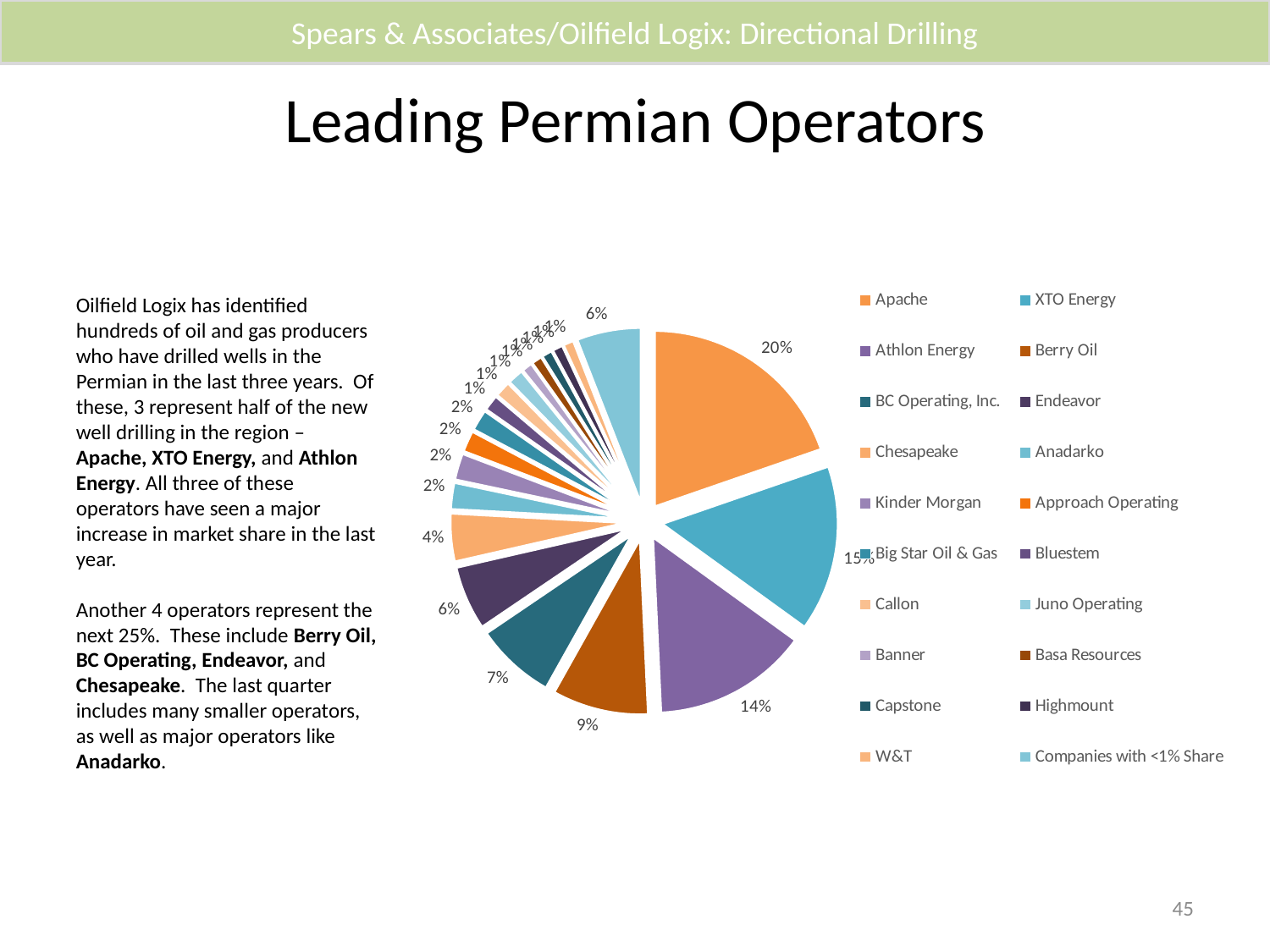
How many percentage points larger is Apache's share than XTO Energy's share? 5 Which operator has the largest slice of the pie? Apache Which has the larger share, Berry Oil or BC Operating, Inc.? Berry Oil What is the title of the slide containing the pie chart? Leading Permian Operators How many entries does the legend list? 20 What share of the pie does XTO Energy hold? 15% What share of the pie does Athlon Energy hold? 14% What share of the pie does BC Operating, Inc. hold? 7% What kind of chart is shown on the slide? Pie chart What share of the pie does Berry Oil hold? 9% What share of the pie does Apache hold? 20% What share of the pie does Chesapeake hold? 4%